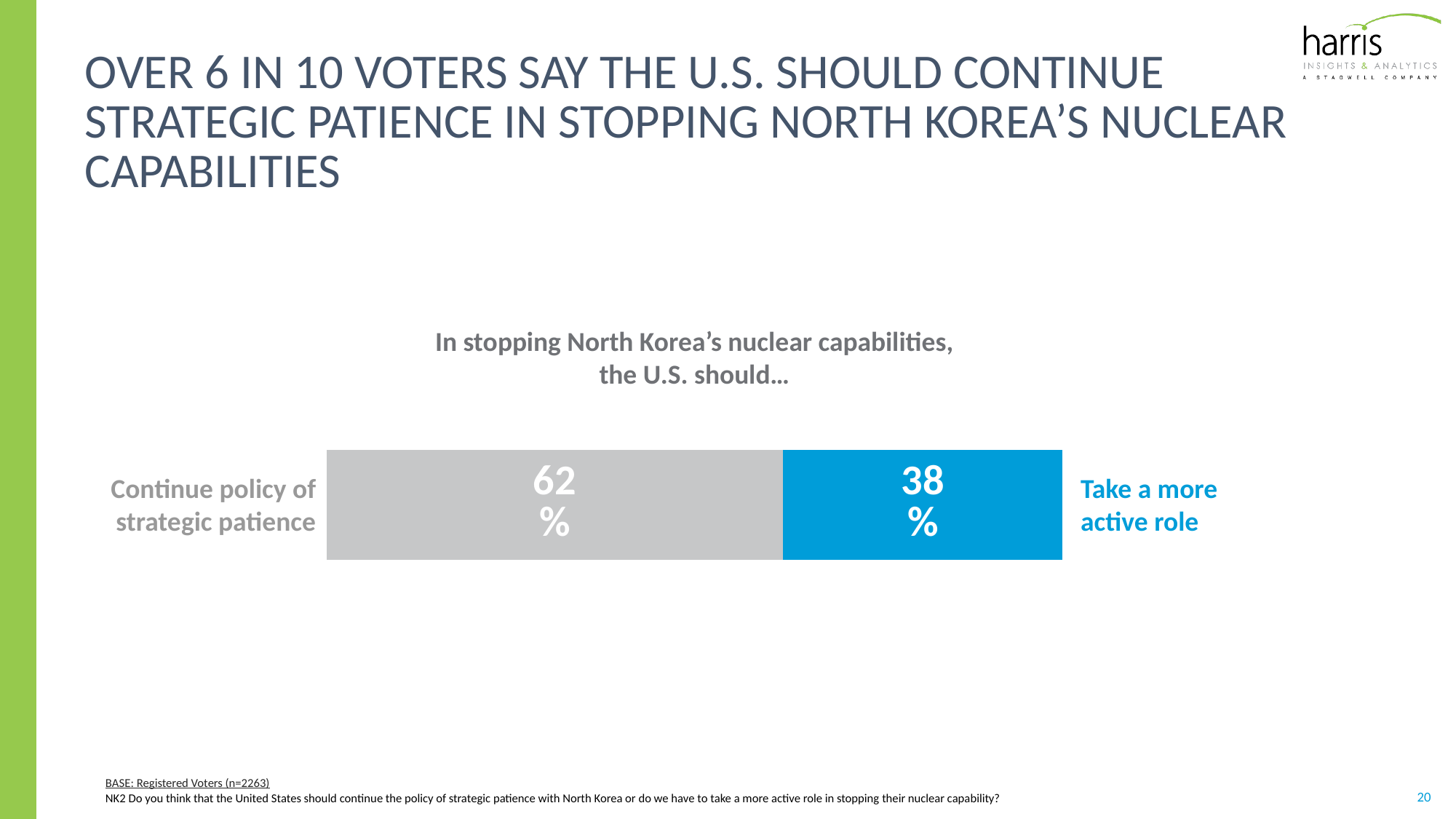
How many response categories are shown in the bar? 2 What kind of chart is shown on the slide? Stacked bar chart What is the total of the two segments in the stacked bar? 100% Which response has the larger share: continue policy of strategic patience or take a more active role? Continue policy of strategic patience What percentage of voters say the U.S. should take a more active role? 38% What colour is the segment for 'Take a more active role'? Blue What is the difference in percentage points between those who want to continue strategic patience and those who want a more active role? 24 Which response has the smallest share? Take a more active role What is the title of the chart? In stopping North Korea's nuclear capabilities, the U.S. should… What percentage of voters say the U.S. should continue the policy of strategic patience? 62%